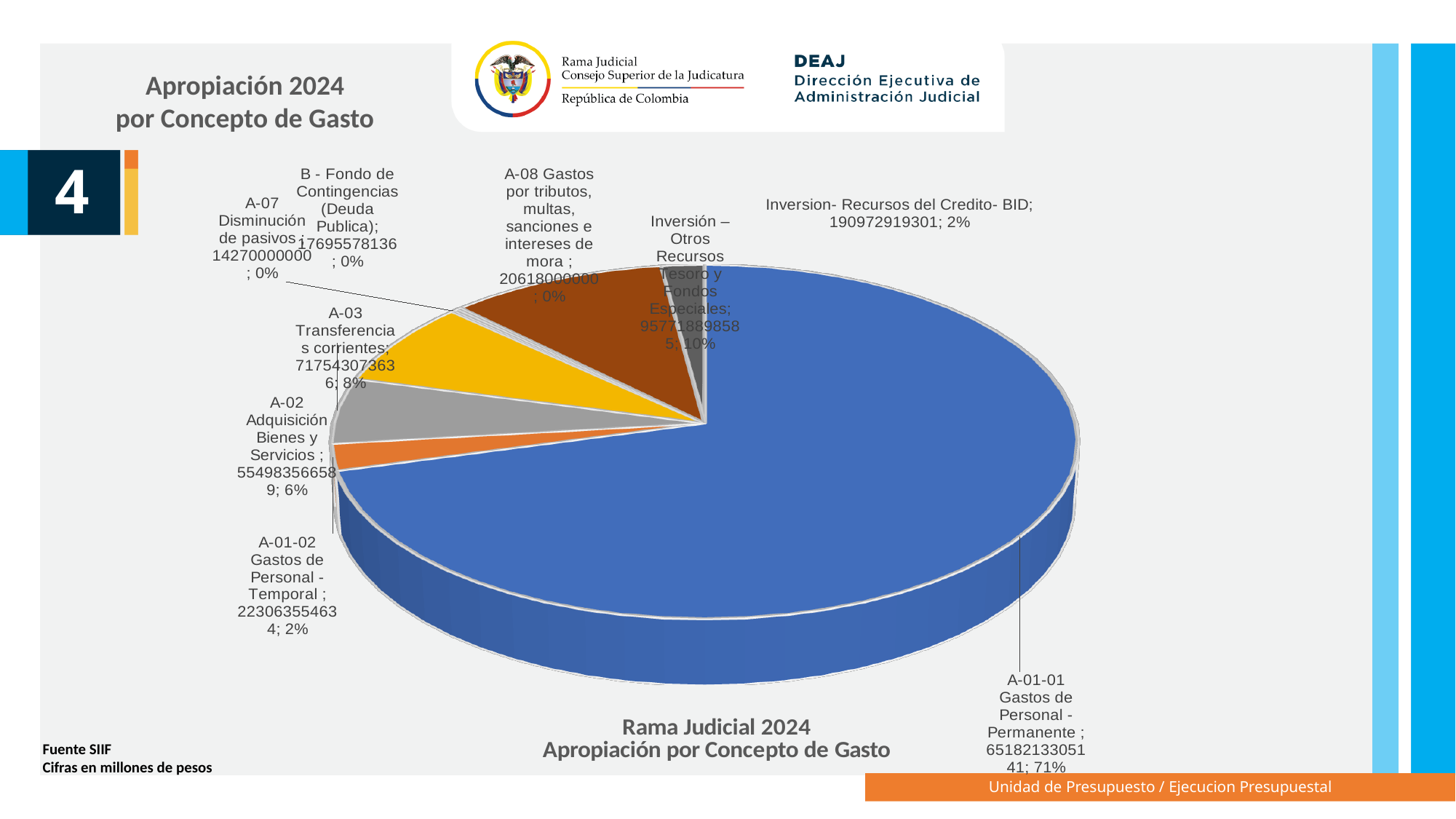
What is the title of the pie chart? Rama Judicial 2024 Apropiación por Concepto de Gasto Which is larger, A-03 Transferencias corrientes or A-02 Adquisición Bienes y Servicios? A-03 Transferencias corrientes What is the value shown for Inversion- Recursos del Credito- BID? 190972919301 Which category has the largest slice of the pie? A-01-01 Gastos de Personal - Permanente What kind of chart is shown on the slide? pie chart What is the value shown for A-07 Disminución de pasivos? 14270000000 What share of the pie does A-01-01 Gastos de Personal - Permanente represent? 71% What share of the pie does Inversión – Otros Recursos Tesoro y Fondos Especiales represent? 10% How many slices does the pie chart have? 9 What share of the pie does A-03 Transferencias corrientes represent? 8% Which category has the smallest value in the pie? A-07 Disminución de pasivos What is the value shown for A-02 Adquisición Bienes y Servicios? 554983566589